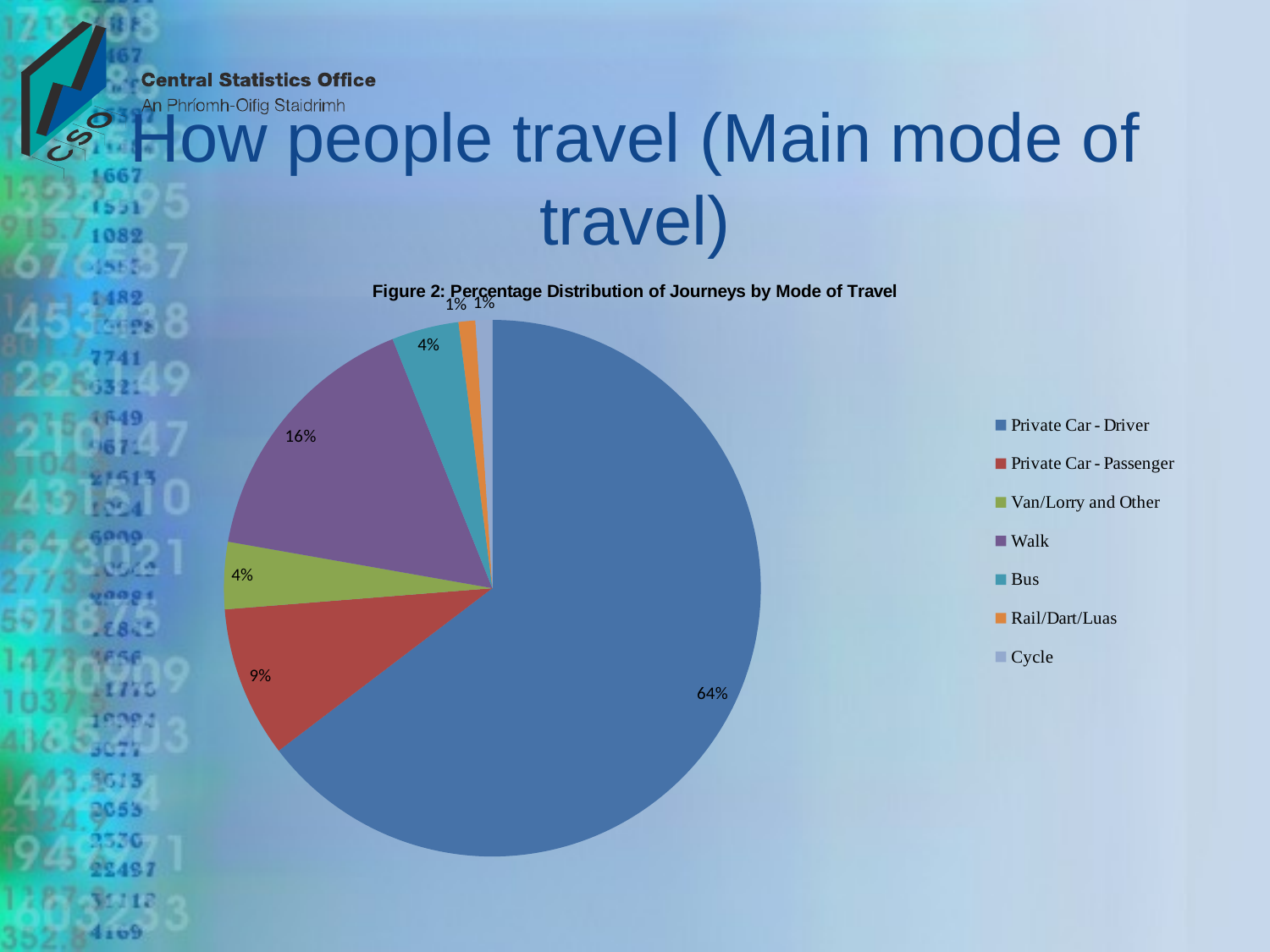
What percentage of journeys is made by bus? 4% What is the difference in percentage points between Private Car - Driver and Walk? 48 What percentage of journeys is made as a Private Car - Passenger? 9% What percentage of journeys is made by Rail/Dart/Luas? 1% What is the difference in percentage points between Walk and Private Car - Passenger? 7 What share of journeys is made by Private Car - Driver? 64% Which has a larger share of journeys, Walk or Bus? Walk How many modes of travel does the legend list? 7 What percentage of journeys is made by walking? 16% What is the title of the chart? Figure 2: Percentage Distribution of Journeys by Mode of Travel What kind of chart is shown on the slide? Pie chart Which mode of travel has the largest share of journeys? Private Car - Driver